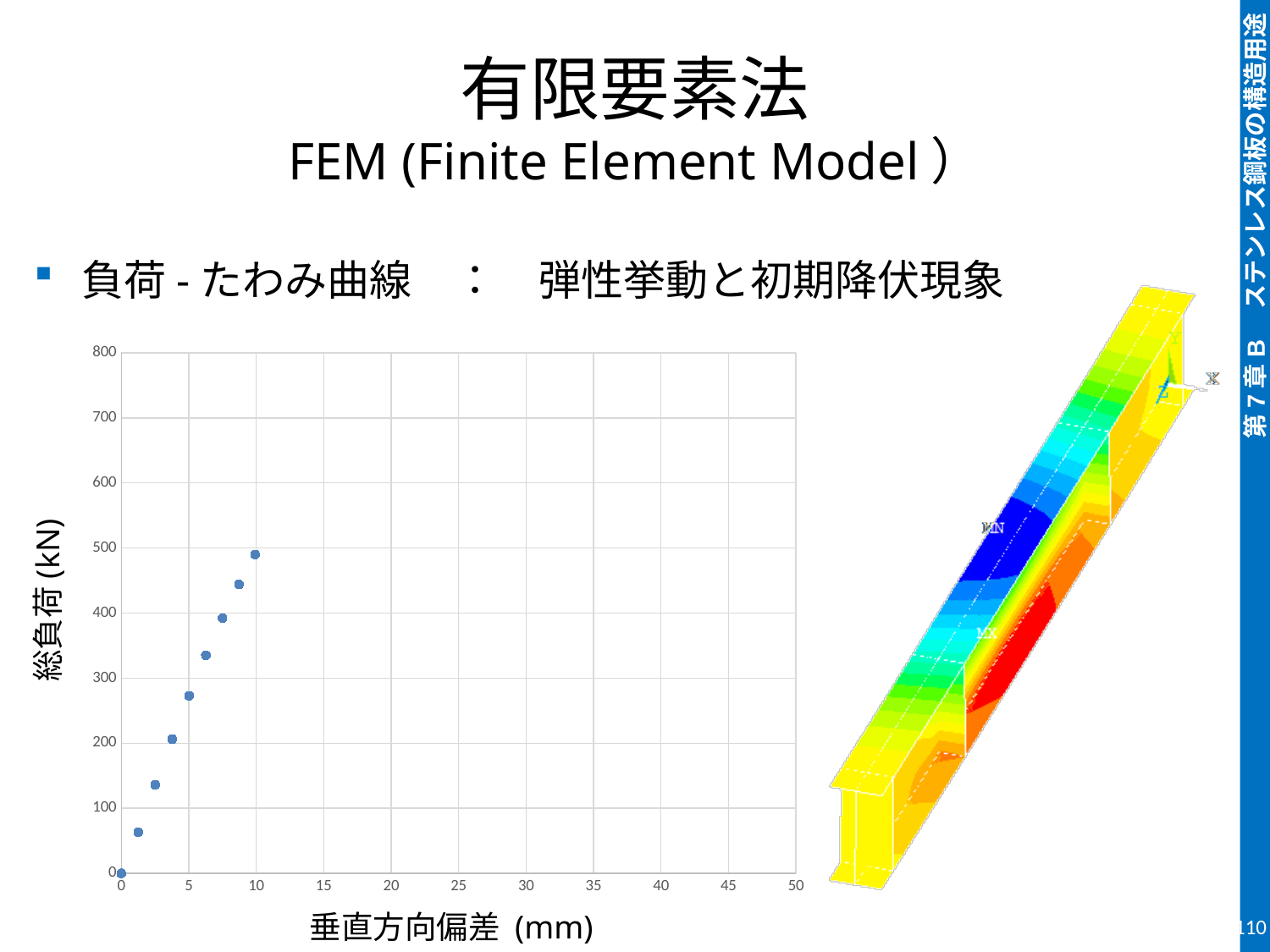
Is the highest plotted load value (総負荷) greater or less than 400 kN? greater Is the highest plotted load value (総負荷) greater or less than 500 kN? less Is the load value of the point at about 5 mm deviation greater or less than 300 kN? less What is the label of the y axis of the chart? 総負荷 (kN) What is the maximum value shown on the x axis of the chart? 50 What is the label of the x axis of the chart? 垂直方向偏差 (mm) Do the plotted values rise or fall as the vertical deviation (垂直方向偏差) increases along the x axis? rise What is the maximum value shown on the y axis of the chart? 800 What kind of chart is shown on the slide? scatter chart How many data points are plotted in the chart? 9